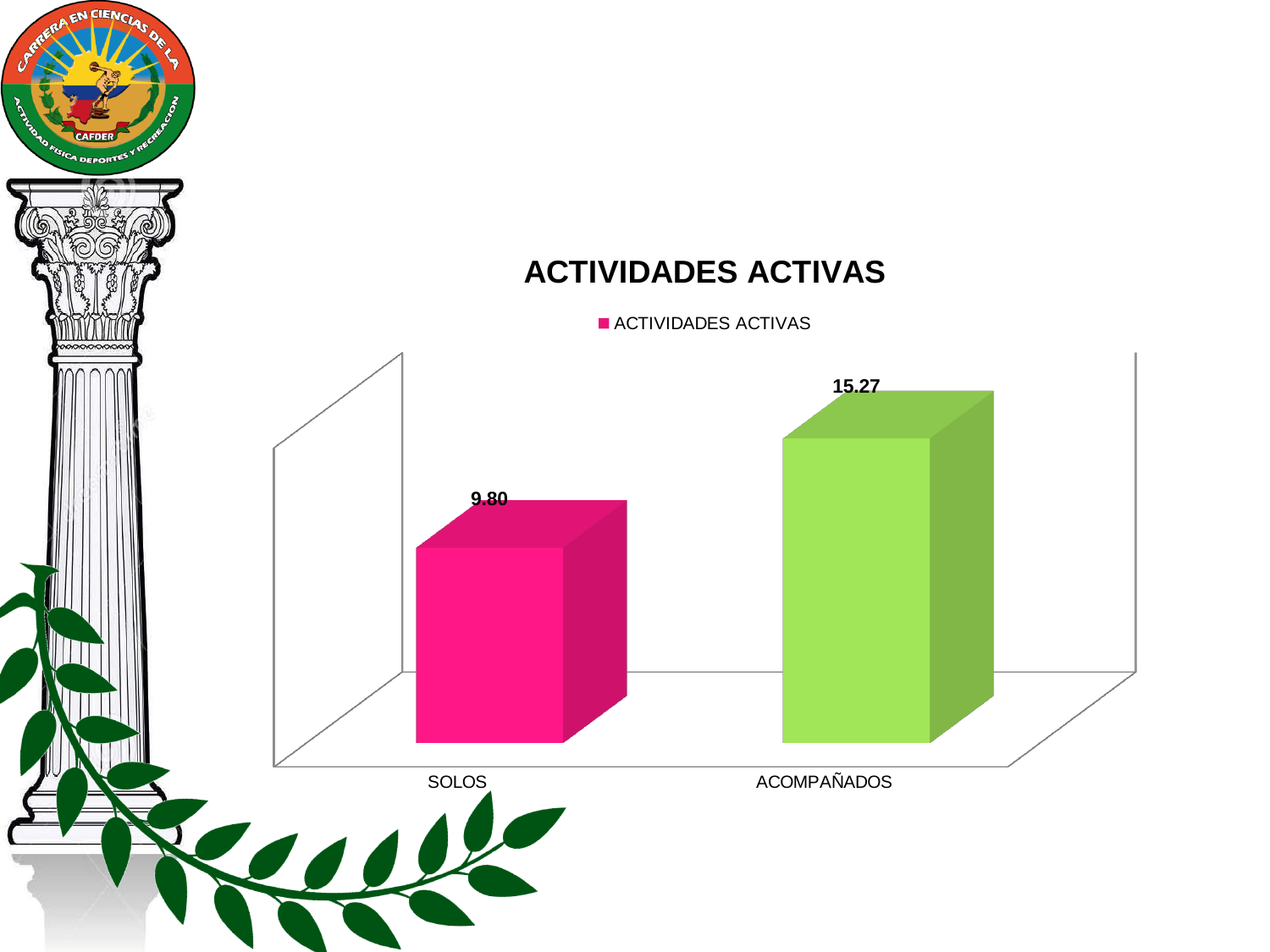
What is the difference between the values for ACOMPAÑADOS and SOLOS? 5.47 What is the title of the chart? ACTIVIDADES ACTIVAS Which is larger, the value for SOLOS or the value for ACOMPAÑADOS? ACOMPAÑADOS What kind of chart is shown on the slide? Bar chart What is the value for SOLOS? 9.80 What is the value for ACOMPAÑADOS? 15.27 Which category has the highest value? ACOMPAÑADOS How many series does the legend list? 1 How many categories are shown on the x axis? 2 Which category has the lowest value? SOLOS What colour is the bar for ACOMPAÑADOS? Green